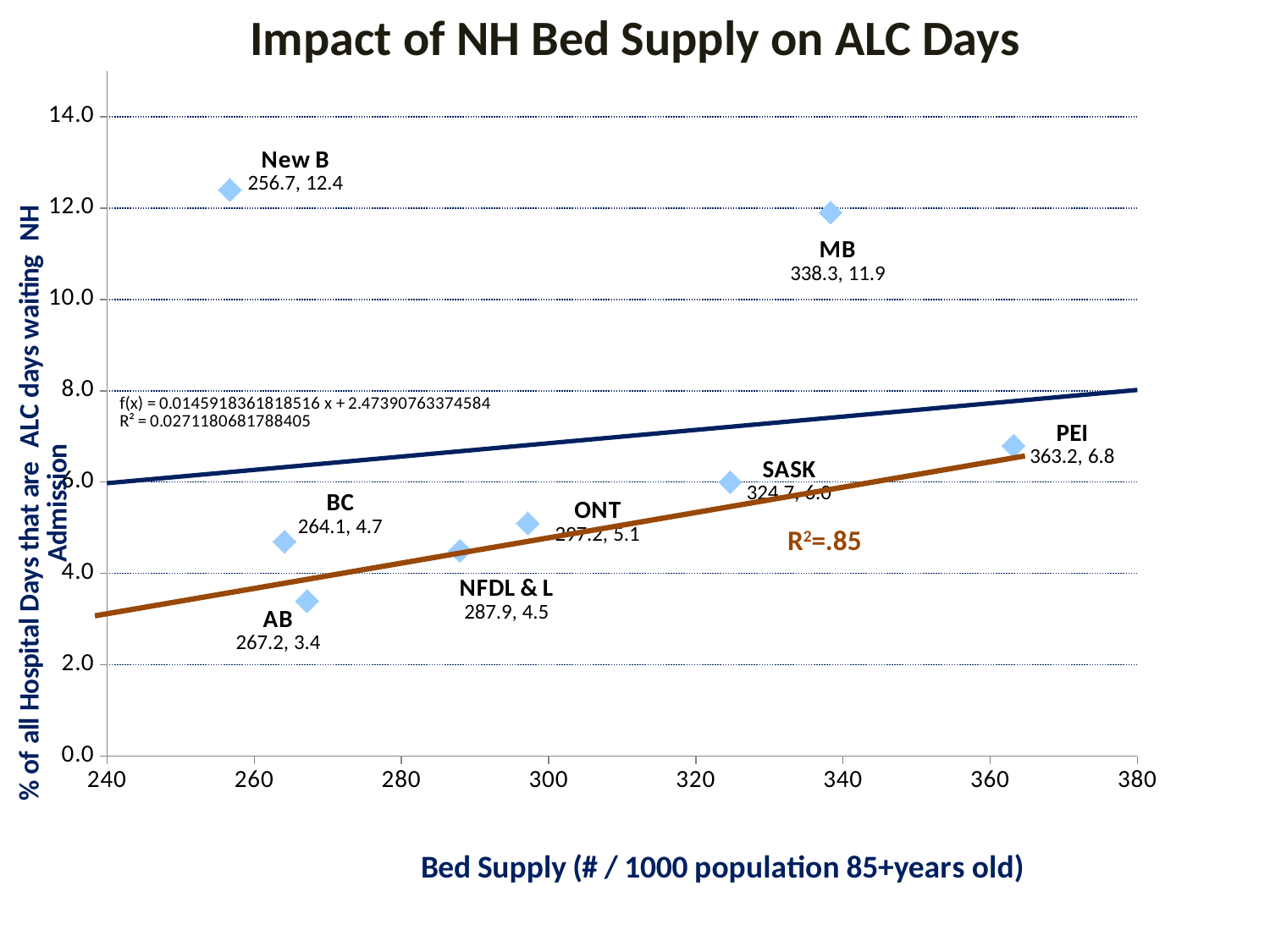
Which province has the highest percentage of ALC days waiting NH admission? New B What is the ALC days percentage for AB? 3.4 What percentage of hospital days are ALC days waiting NH admission for New B? 12.4 How many provinces are plotted on the chart? 8 What is the bed supply value for PEI? 363.2 What R² value is shown in orange next to the orange trend line? R²=.85 Which province has the lowest percentage of ALC days waiting NH admission? AB Which province has the highest bed supply? PEI What is the bed supply value for MB? 338.3 Which has a higher ALC days percentage, BC or NFDL & L? BC What kind of chart is shown on the slide? scatter chart What is the difference in ALC days percentage between New B and MB? 0.5